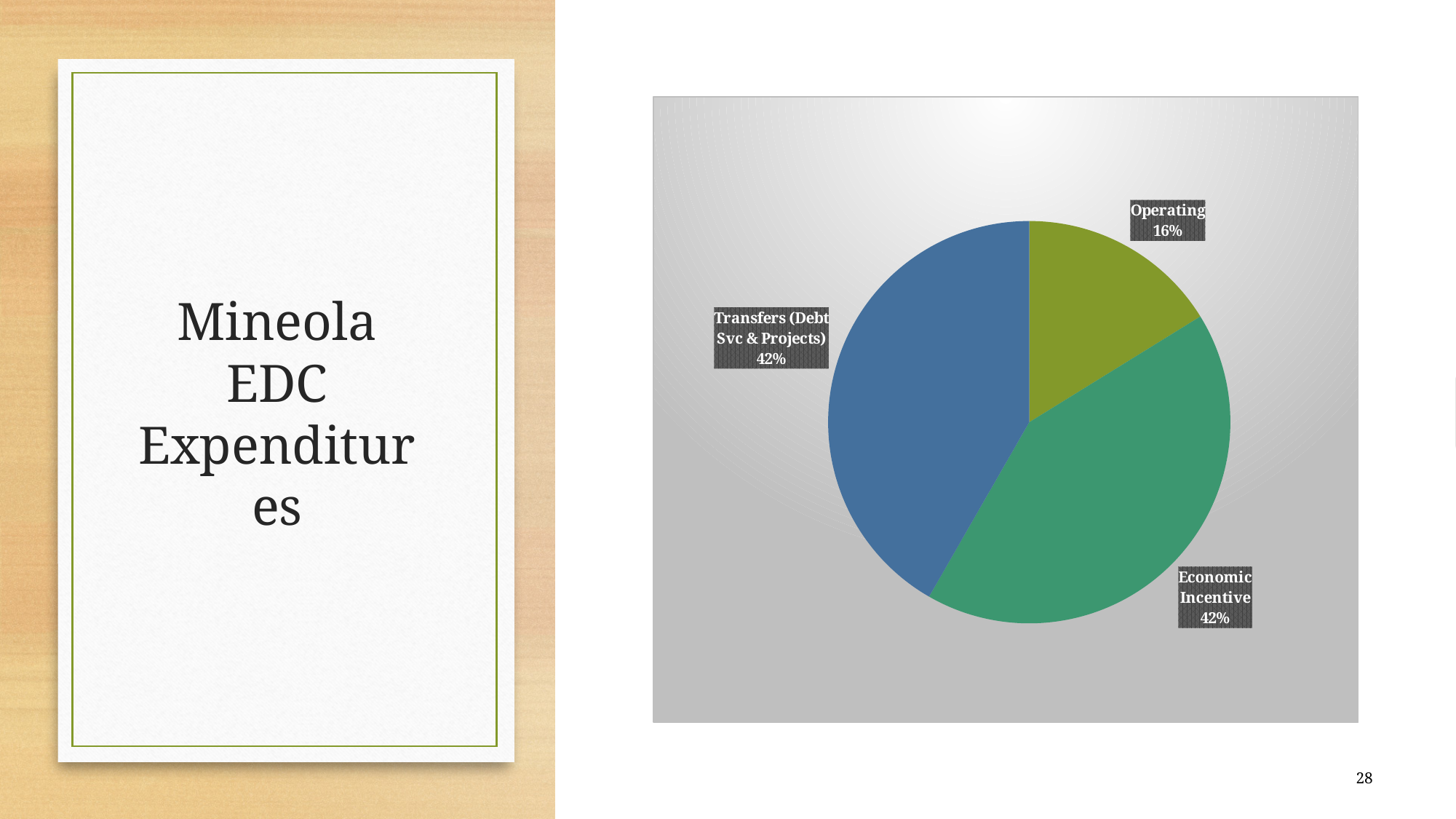
How many slices does the pie chart have? 3 What share of the pie does Operating represent? 16% What colour is the Operating slice? olive green What is the difference between the Economic Incentive share and the Operating share? 26% What share of the pie does Transfers (Debt Svc & Projects) represent? 42% Which is larger, the Operating slice or the Economic Incentive slice? Economic Incentive Which slice of the pie is the smallest? Operating What kind of chart is shown on the slide? pie chart What colour is the Transfers (Debt Svc & Projects) slice? blue What is the combined share of Economic Incentive and Transfers (Debt Svc & Projects)? 84% What share of the pie does Economic Incentive represent? 42%